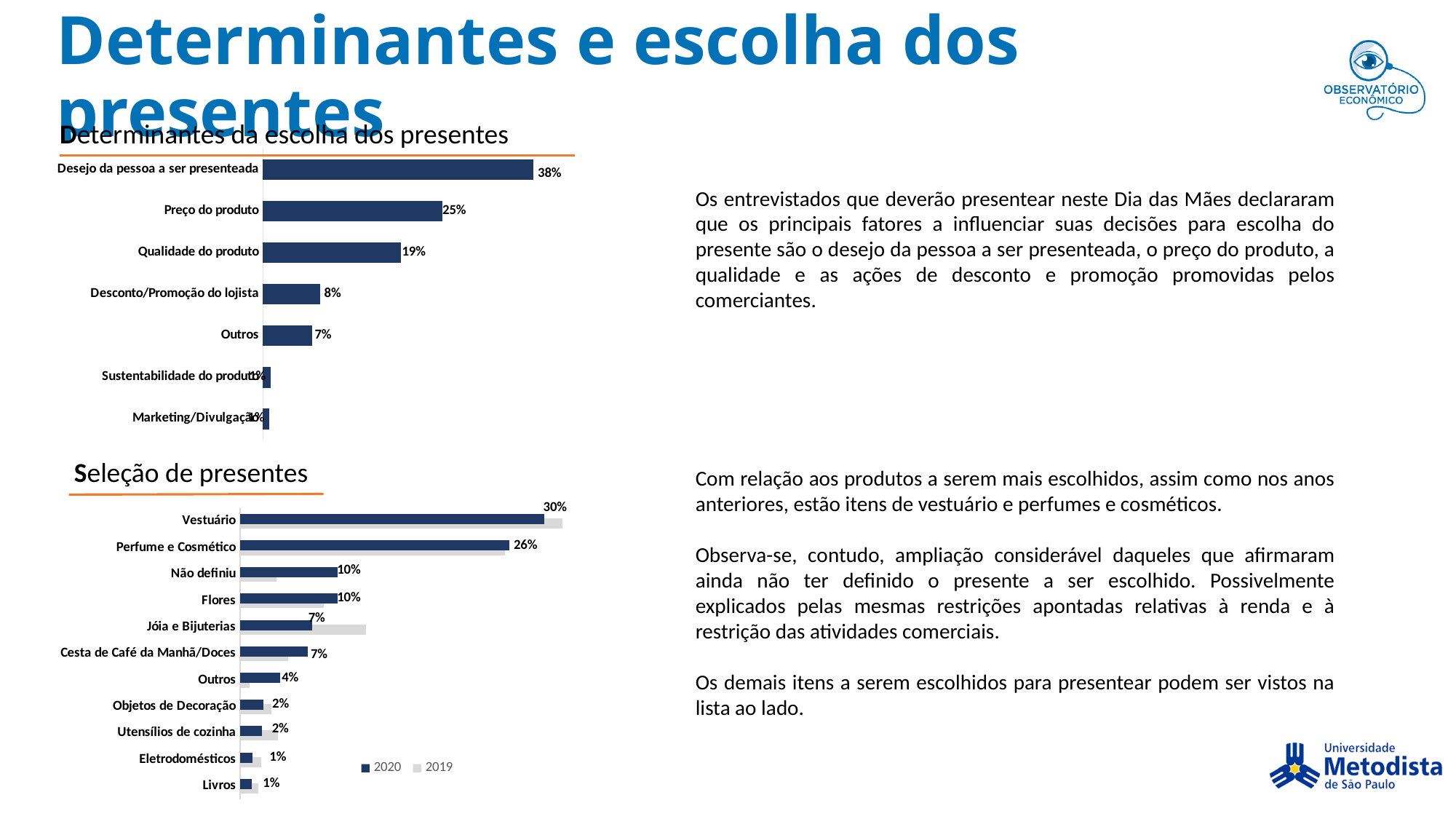
In the 'Determinantes da escolha dos presentes' chart, what is the difference between 'Desejo da pessoa a ser presenteada' and 'Qualidade do produto'? 19% In the 'Seleção de presentes' chart, what is the 2020 value for 'Perfume e Cosmético'? 26% In the 'Seleção de presentes' chart, what is the difference between the 2020 values for 'Vestuário' and 'Não definiu'? 20% In the 'Determinantes da escolha dos presentes' chart, how many categories are shown? 7 In the 'Seleção de presentes' chart, how many categories are shown? 11 In the 'Seleção de presentes' chart, which category has the highest 2020 value? Vestuário What kind of chart is the 'Seleção de presentes' chart? Bar chart In the 'Seleção de presentes' chart, how many series does the legend list? 2 In the 'Seleção de presentes' chart, for 'Jóia e Bijuterias', which year has the larger value: 2020 or 2019? 2019 In the 'Determinantes da escolha dos presentes' chart, what is the value for 'Preço do produto'? 25% In the 'Determinantes da escolha dos presentes' chart, which category has the highest value? Desejo da pessoa a ser presenteada In the 'Determinantes da escolha dos presentes' chart, which is larger: 'Desconto/Promoção do lojista' or 'Outros'? Desconto/Promoção do lojista